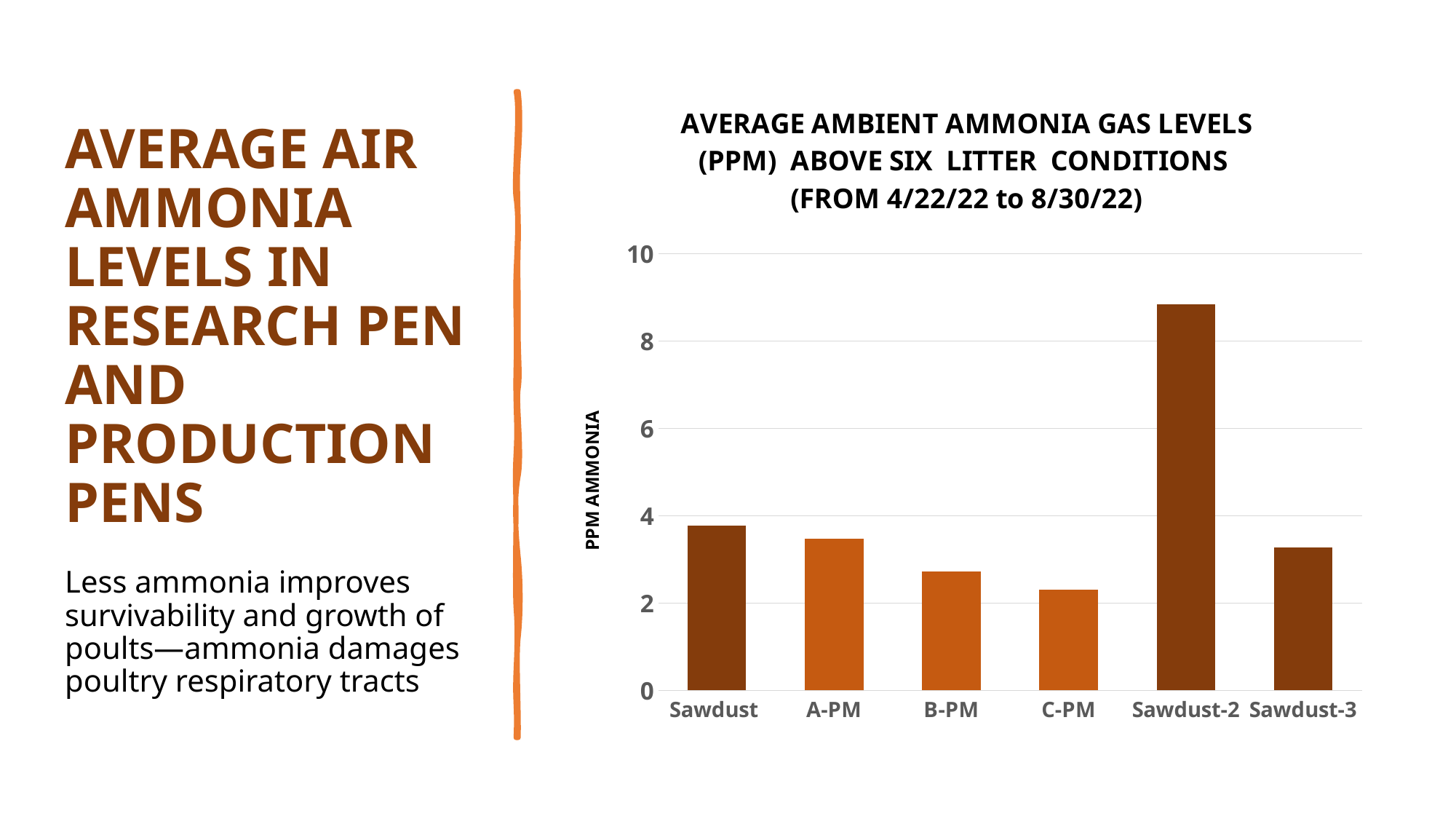
Which has a higher average ammonia level, B-PM or C-PM? B-PM Which has a higher average ammonia level, Sawdust or Sawdust-3? Sawdust Is the value for Sawdust-3 greater or less than 2? greater What is the label on the vertical axis of the chart? PPM AMMONIA Is the value for B-PM greater or less than 4? less Is the value for Sawdust greater or less than 4? less Which litter condition has the highest average ammonia level? Sawdust-2 What kind of chart is shown on the slide? bar chart How many litter conditions are plotted on the x axis? 6 Which litter condition has the lowest average ammonia level? C-PM